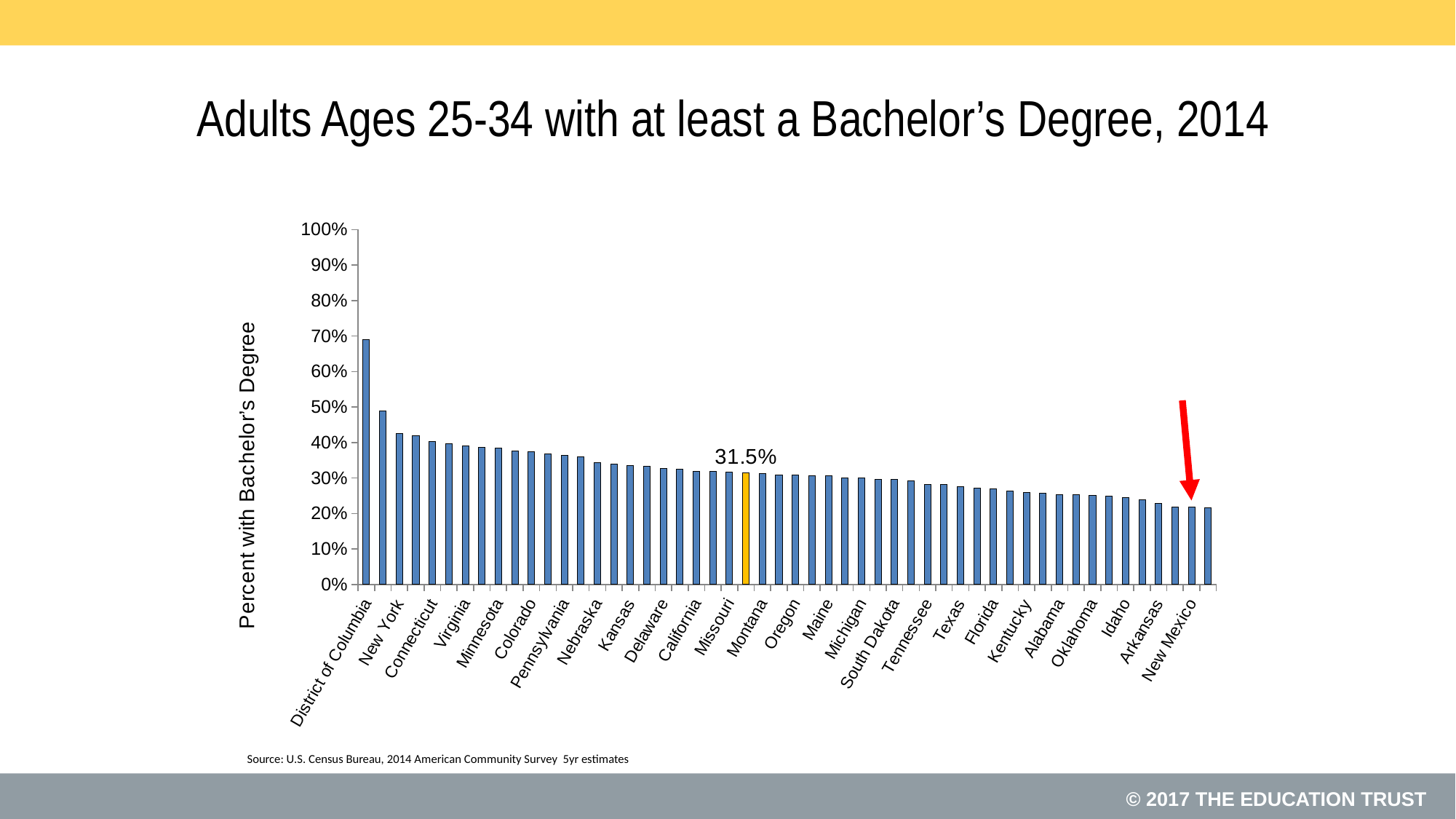
Is the value for District of Columbia greater or less than 60%? greater Which has a larger value, New York or Connecticut? New York What is the label on the vertical axis of the chart? Percent with Bachelor's Degree Is the value for Kentucky greater or less than 30%? less Is the value for Minnesota greater or less than 30%? greater What kind of chart is shown on the slide? bar chart What value is printed above the orange highlighted bar? 31.5% What is the title of the chart? Adults Ages 25-34 with at least a Bachelor's Degree, 2014 Which category has the highest value in the chart? District of Columbia Which has a larger value, Colorado or Texas? Colorado Do the bar values rise or fall moving from left to right along the x axis? fall